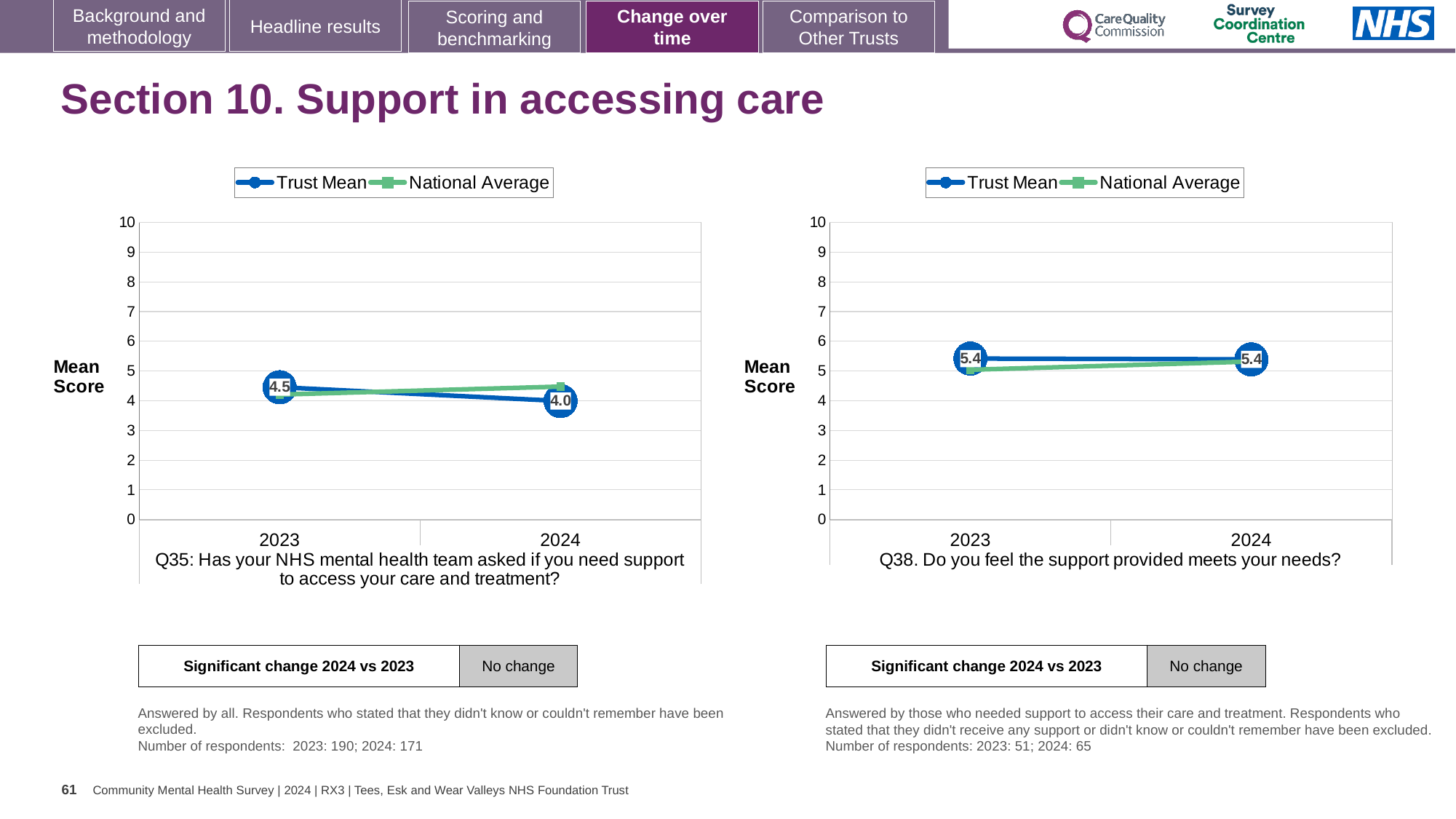
In the Q38 chart on the right, is the National Average for 2023 greater or less than 6? less In the Q38 chart on the right, does the Trust Mean rise, fall or stay the same from 2023 to 2024? stay the same In the Q35 chart on the left, what is the Trust Mean for 2024? 4.0 In the Q35 chart on the left, does the Trust Mean rise or fall from 2023 to 2024? fall In the Q35 chart on the left, what is the Trust Mean for 2023? 4.5 In the Q38 chart on the right, what is the Trust Mean for 2024? 5.4 What kind of chart is the Q38 chart on the right? line chart In the Q35 chart on the left, what is the difference between the Trust Mean in 2023 and in 2024? 0.5 In the Q35 chart on the left, which year has the higher Trust Mean, 2023 or 2024? 2023 In the Q35 chart on the left, is the National Average for 2023 greater or less than 5? less How many series does the legend of the Q35 chart on the left list? 2 How many years are shown on the x axis of the Q38 chart on the right? 2